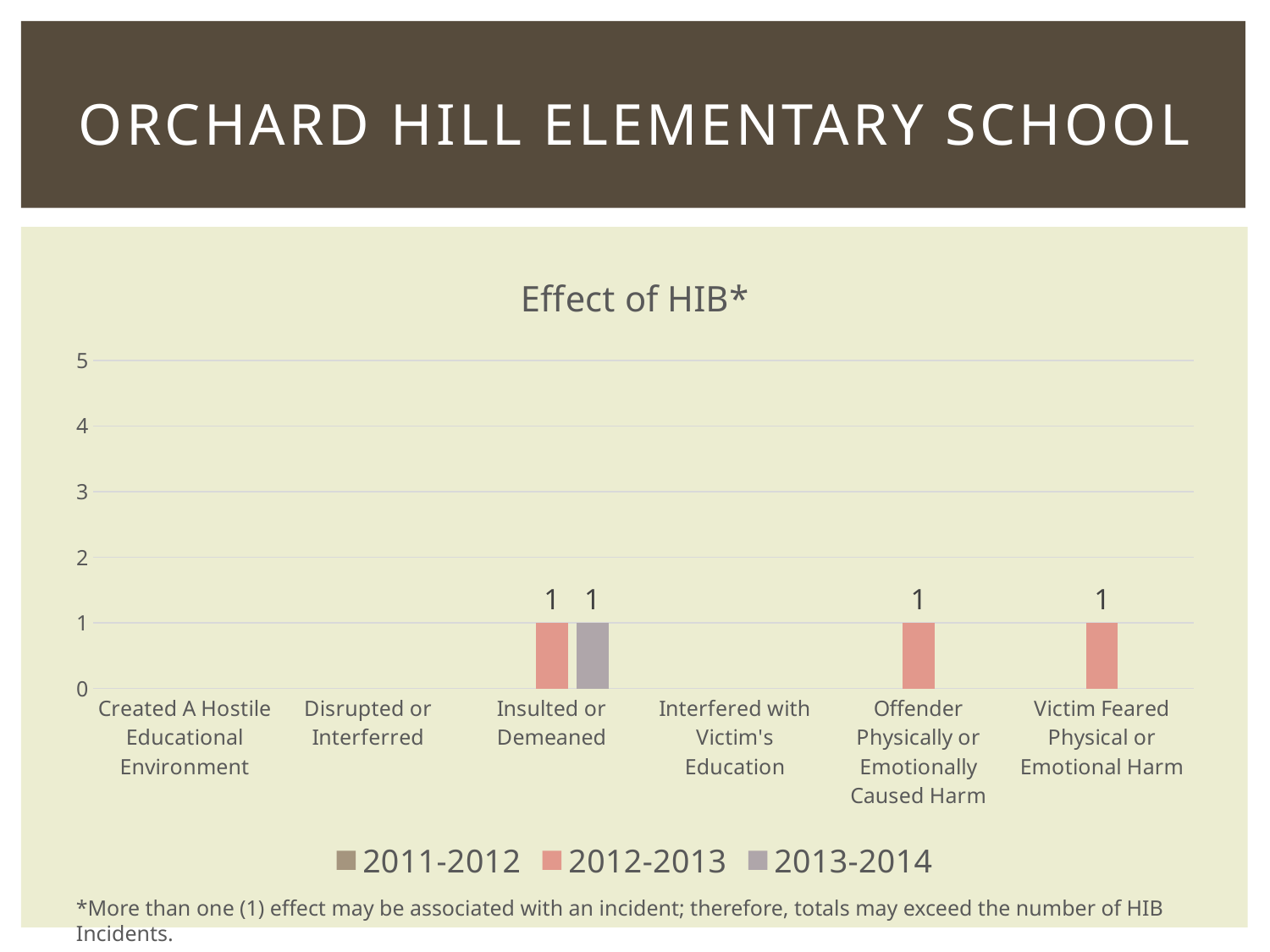
What is the difference between the 2012-2013 and 2013-2014 values in the Insulted or Demeaned category? 0 What is the value for 2012-2013 in the Insulted or Demeaned category? 1 What is the value for 2012-2013 in the Victim Feared Physical or Emotional Harm category? 1 What is the value for 2012-2013 in the Offender Physically or Emotionally Caused Harm category? 1 What kind of chart is shown on the slide? Bar chart How many series does the legend list? 3 How many categories have a bar for the 2012-2013 series? 3 Is the value for 2012-2013 in the Insulted or Demeaned category greater or less than 2? less How many categories are shown on the x axis? 6 What is the title of the chart? Effect of HIB* What is the value for 2013-2014 in the Insulted or Demeaned category? 1 Which series are listed in the legend? 2011-2012, 2012-2013, 2013-2014